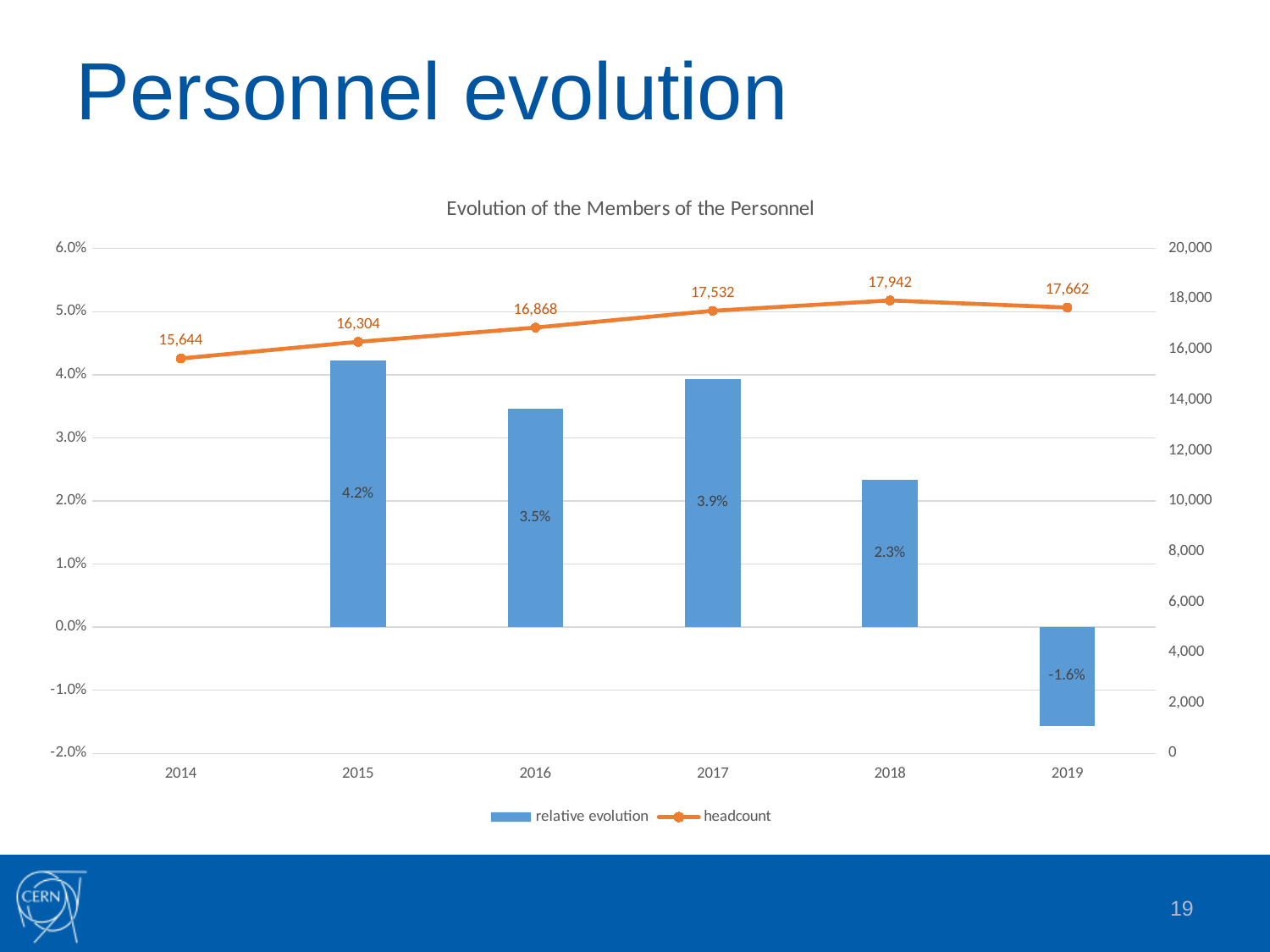
Which is larger, the relative evolution for 2015 or for 2017? 2015 What is the difference in headcount between 2018 and 2019? 280 What is the headcount for 2014? 15,644 Which year has the highest headcount? 2018 How many years are shown on the x axis? 6 How many series does the legend list? 2 What is the relative evolution for 2019? -1.6% Does the headcount rise or fall from 2014 to 2018? rise Which year has the lowest relative evolution? 2019 What is the relative evolution for 2016? 3.5% What is the title of the chart? Evolution of the Members of the Personnel What is the headcount for 2018? 17,942